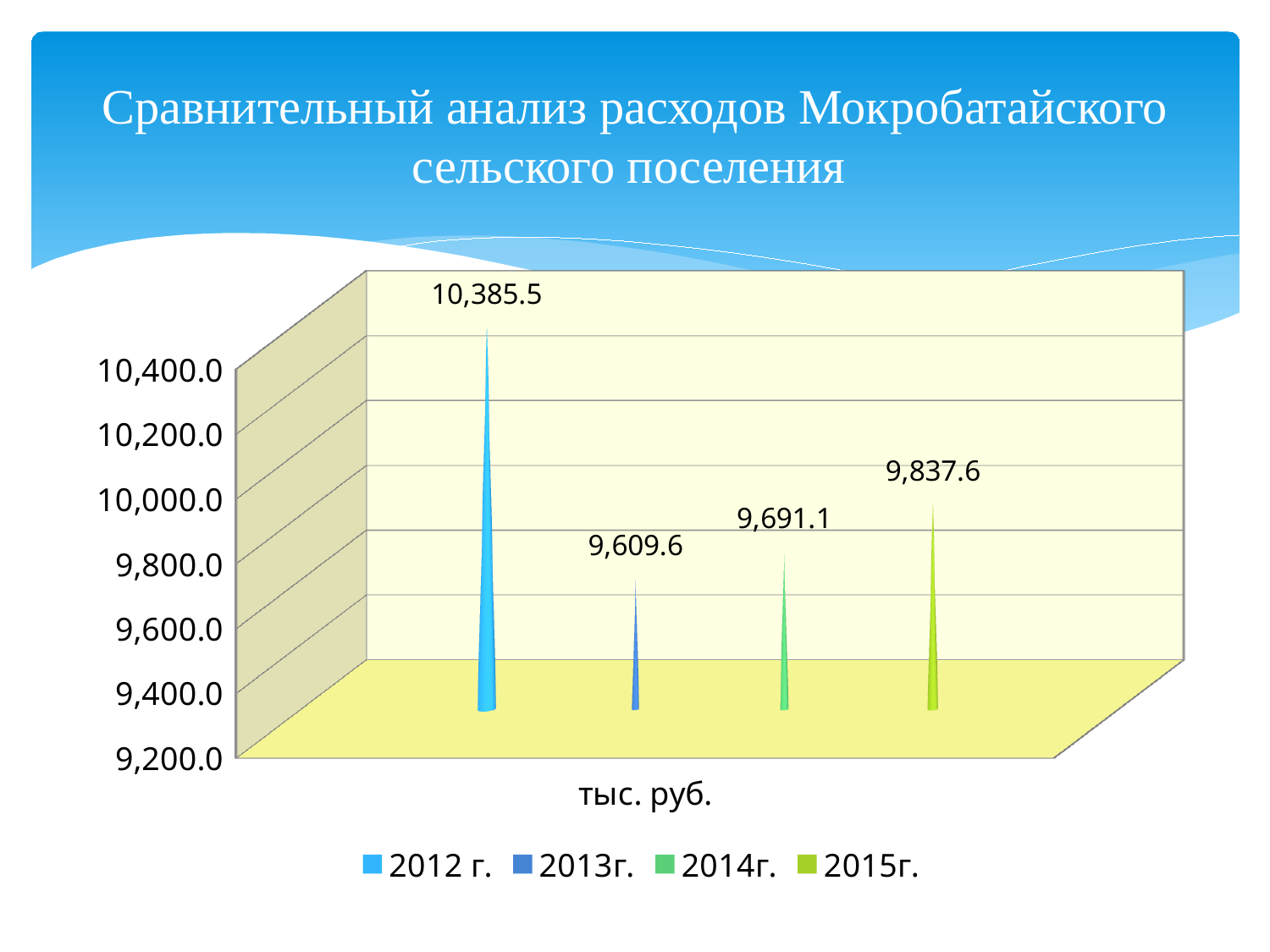
Which year has the highest value? 2012 г. What kind of chart is shown on the slide? bar chart What is the value for 2012 г.? 10,385.5 What is the value for 2013г.? 9,609.6 What is the value for 2015г.? 9,837.6 What is the difference between the values for 2015г. and 2014г.? 146.5 What is the value for 2014г.? 9,691.1 What unit label is shown under the chart's x axis? тыс. руб. Which year has the lowest value? 2013г. What is the difference between the values for 2012 г. and 2013г.? 775.9 How many series does the legend list? 4 Which is larger, the value for 2014г. or the value for 2015г.? 2015г.